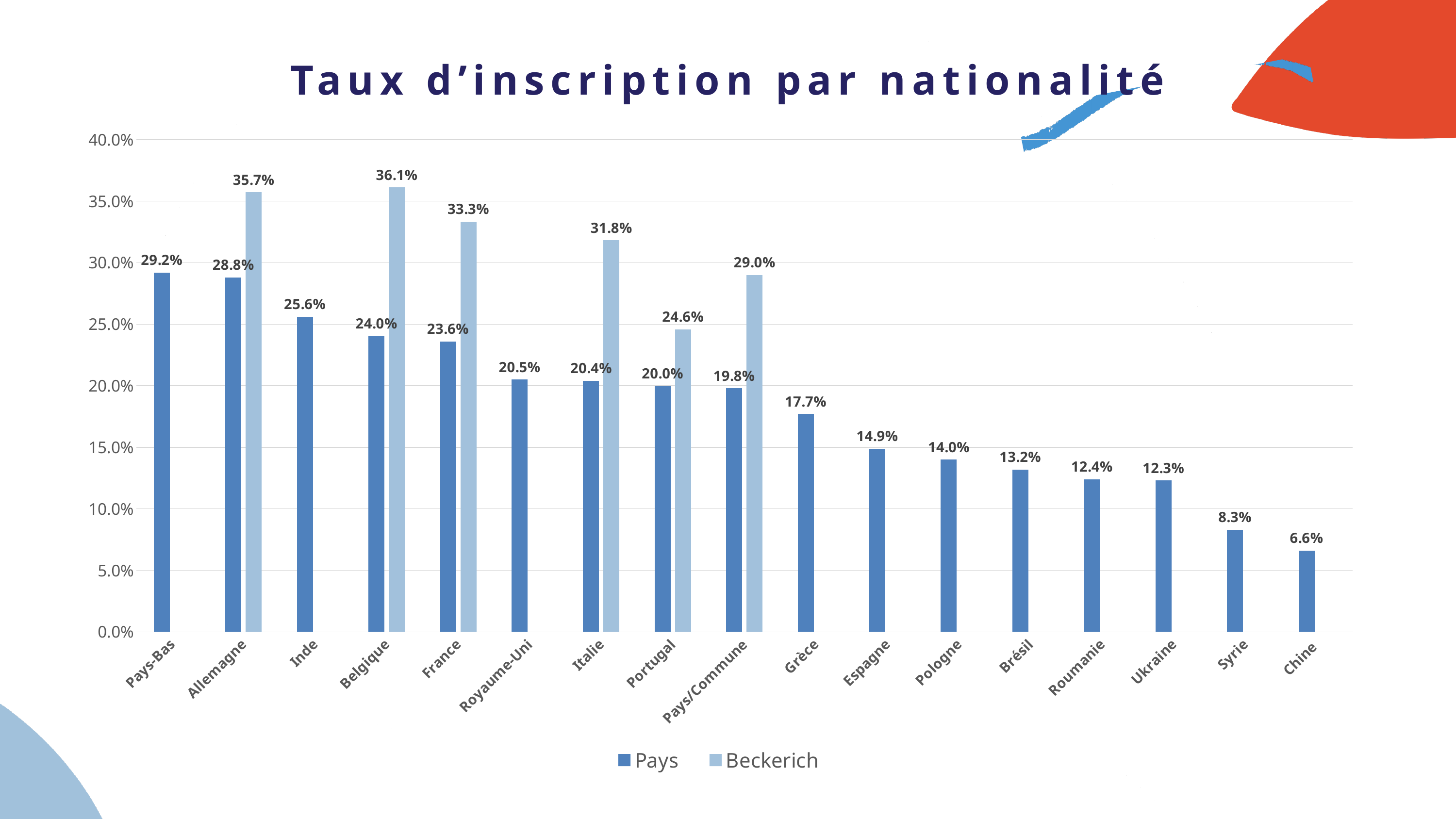
Which category has the highest Beckerich value? Belgique Which category has the lowest Pays value? Chine What is the Beckerich value for Belgique? 36.1% What is the Pays value for Grèce? 17.7% What is the difference between the Beckerich and Pays values for Allemagne? 6.9% Which is larger for France: the Pays value or the Beckerich value? Beckerich What kind of chart is shown on the slide? bar chart Is the Pays value for Syrie greater or less than 10.0%? less What is the Pays value for Pays-Bas? 29.2% How many categories are shown on the x axis? 17 How many series does the legend list? 2 What is the title of the chart? Taux d’inscription par nationalité